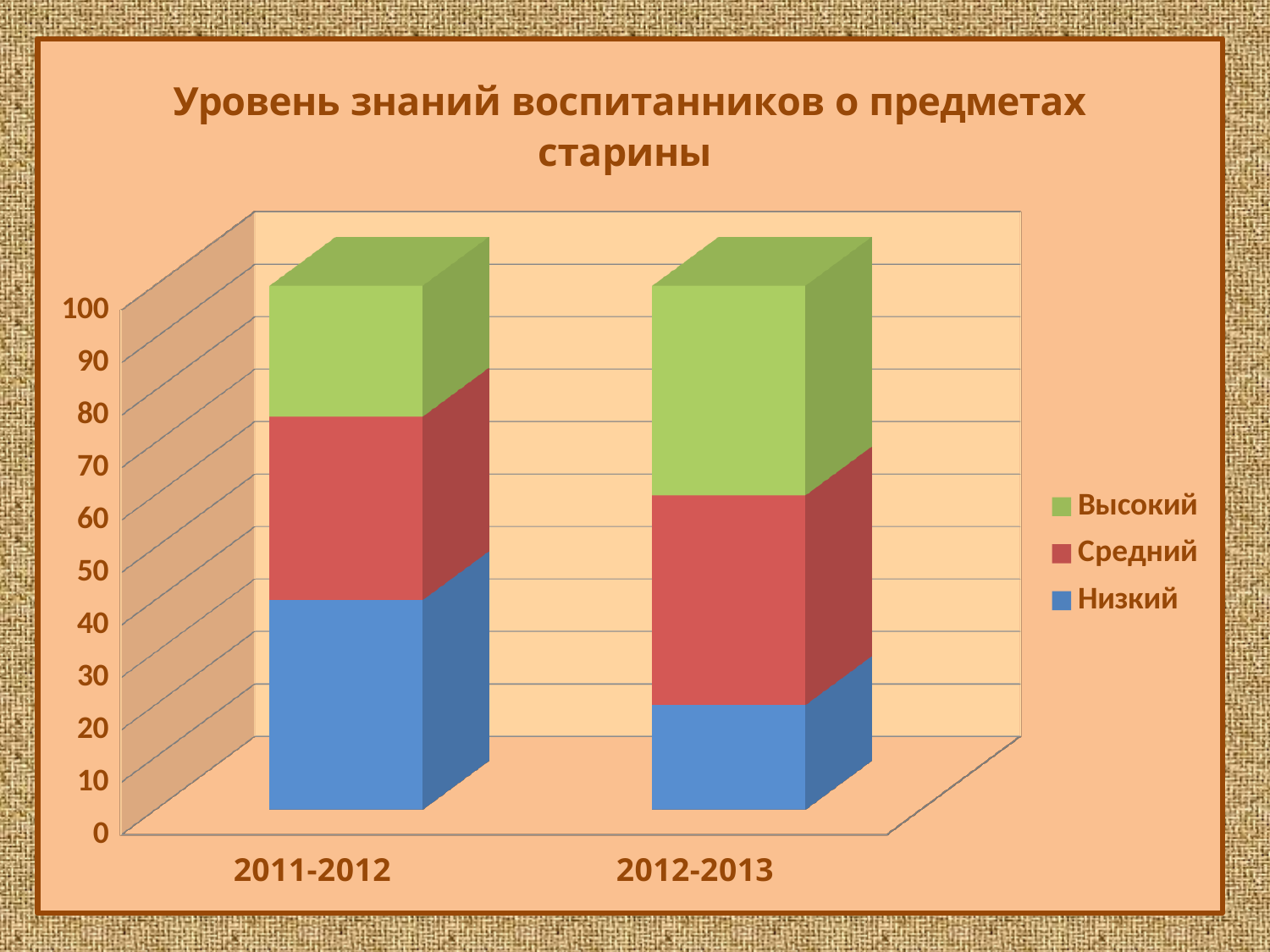
Which year has the larger value for Средний, 2011-2012 or 2012-2013? 2012-2013 How many series does the legend list? 3 Is the value for Низкий in 2012-2013 greater or less than 40? less What kind of chart is shown on the slide? Stacked bar chart Does the Низкий series rise or fall from 2011-2012 to 2012-2013? fall Is the value for Низкий in 2011-2012 greater or less than 30? greater Does the Высокий series rise or fall from 2011-2012 to 2012-2013? rise Which series is shown in blue in the legend? Низкий How many categories are shown on the x axis? 2 Which year has the larger value for Высокий, 2011-2012 or 2012-2013? 2012-2013 What is the title of the chart? Уровень знаний воспитанников о предметах старины Which year has the larger value for Низкий, 2011-2012 or 2012-2013? 2011-2012